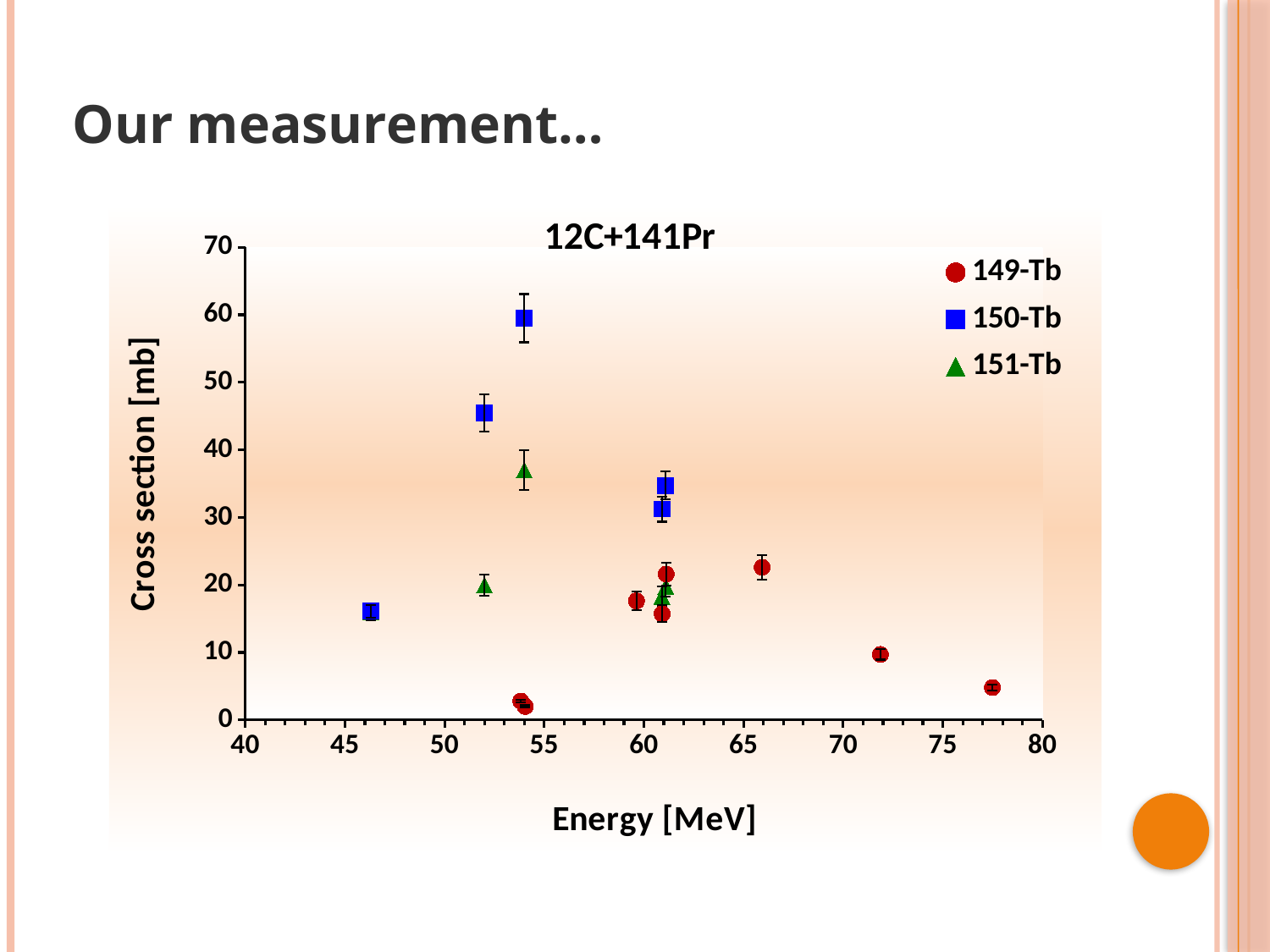
Do the 149-Tb values rise or fall as energy increases from about 66 MeV to about 77 MeV? fall Which series has the lowest cross section value on the chart? 149-Tb Is the highest 151-Tb value greater or less than 30 mb? greater Which series has the highest cross section value on the chart? 150-Tb Is the highest 150-Tb value greater or less than 50 mb? greater How many series does the legend list? 3 What is the title of the chart? 12C+141Pr What is the label of the y axis? Cross section [mb] Is the 149-Tb value at the highest energy (around 77 MeV) greater or less than 10 mb? less What kind of chart is shown on the slide? scatter chart